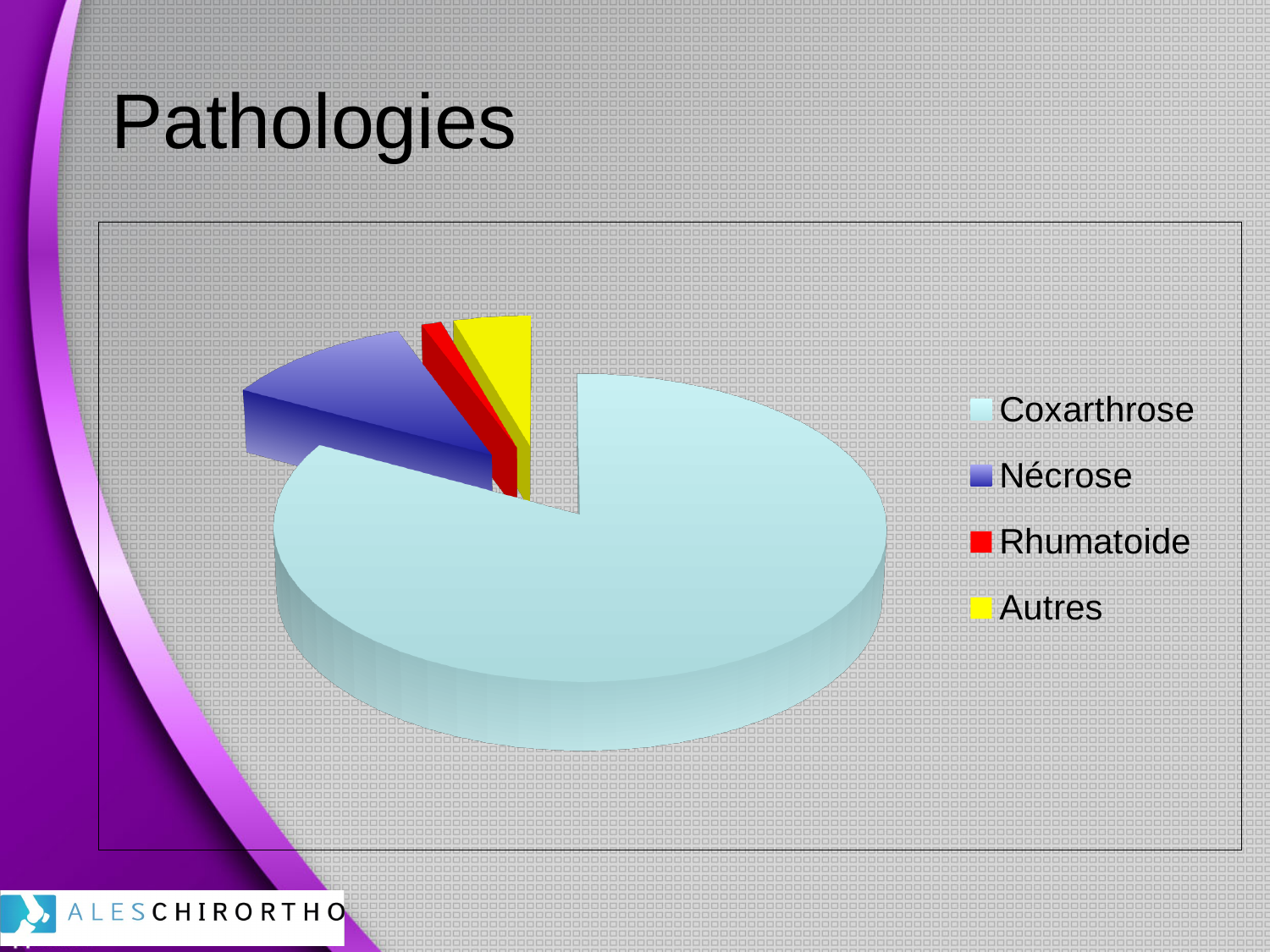
Which slice is larger, Nécrose or Autres? Nécrose Which category is shown in yellow in the pie chart? Autres Which category has the largest slice of the pie chart? Coxarthrose What colour is the Rhumatoide slice in the pie chart? red How many slices does the pie chart have? 4 What kind of chart is shown on the slide? pie chart Which category has the smallest slice of the pie chart? Rhumatoide Which slice is larger, Coxarthrose or Nécrose? Coxarthrose How many entries does the legend of the pie chart list? 4 Does the Coxarthrose slice account for more or less than half of the pie? more Which slice is larger, Autres or Rhumatoide? Autres